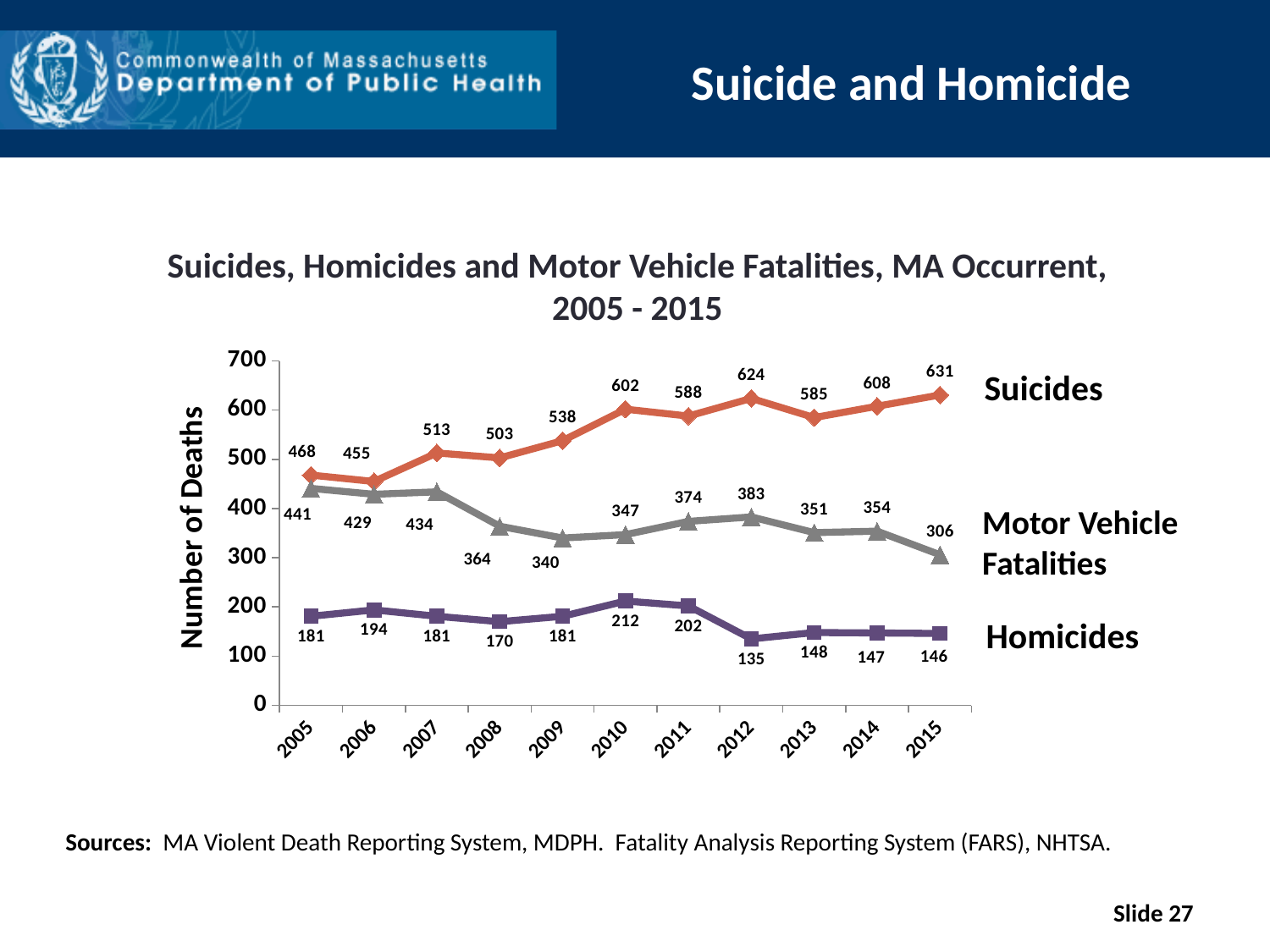
What is the label of the y axis? Number of Deaths What was the number of motor vehicle fatalities in 2015? 306 What type of chart is shown on the slide? Line chart Overall, did the number of suicides rise or fall from 2005 to 2015? Rise How many suicides were recorded in 2012? 624 How many series are plotted on the chart? 3 How many homicides were recorded in 2010? 212 Which was larger in 2005: suicides or motor vehicle fatalities? Suicides In which year was the number of homicides lowest? 2012 What is the difference between suicides and homicides in 2015? 485 How many years are plotted on the x axis? 11 In which year was the number of suicides highest? 2015